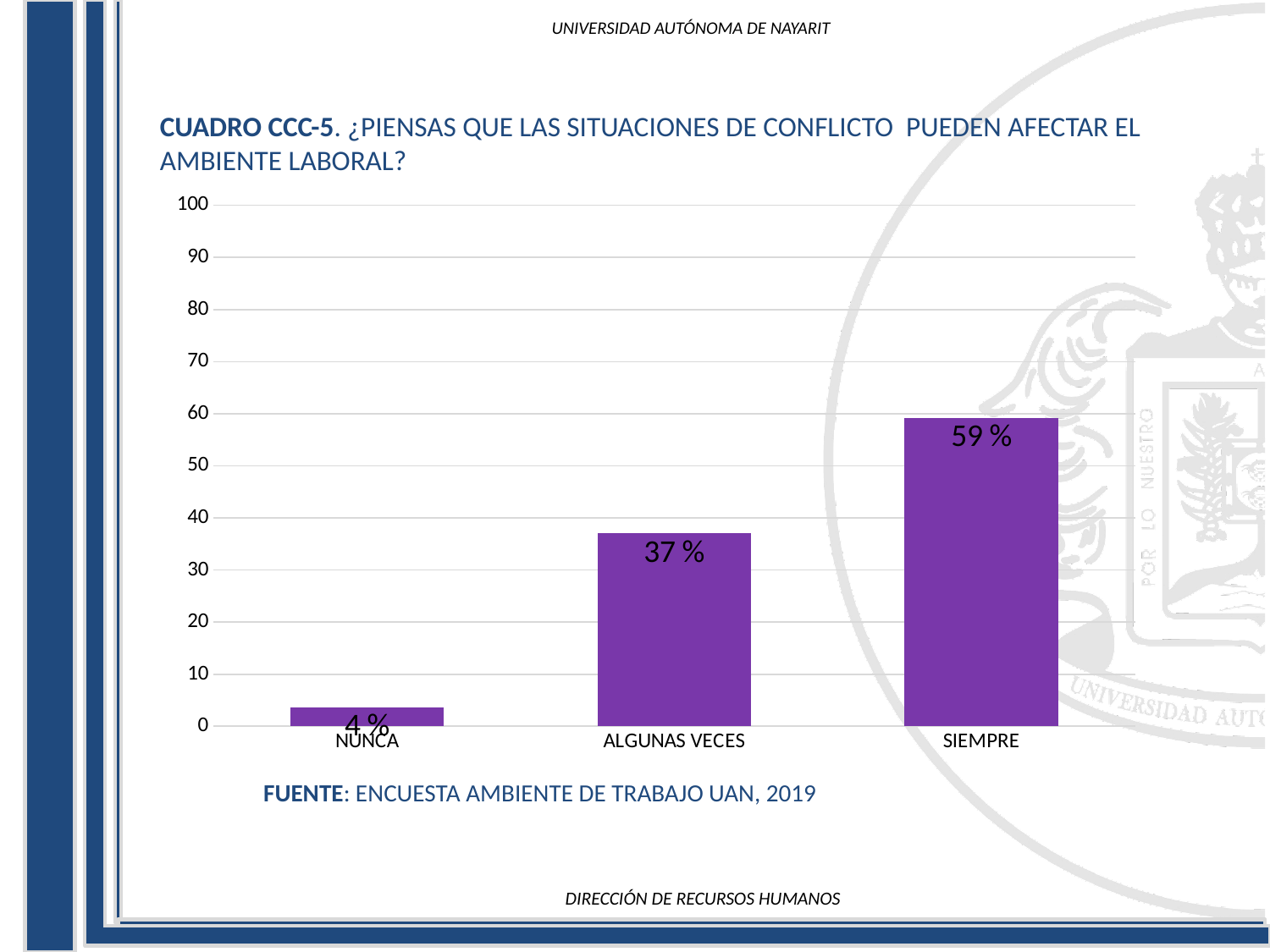
Do the values rise or fall from NUNCA to SIEMPRE along the x axis? rise What is the value for NUNCA? 4 % What is the value for SIEMPRE? 59 % What is the value for ALGUNAS VECES? 37 % What is the difference between the values for SIEMPRE and ALGUNAS VECES? 22 % Is the value for ALGUNAS VECES greater or less than 40? less What kind of chart is shown on the slide? bar chart Which is larger, the value for ALGUNAS VECES or the value for NUNCA? ALGUNAS VECES How many categories are shown on the x axis? 3 What source is cited below the chart? ENCUESTA AMBIENTE DE TRABAJO UAN, 2019 Which category has the lowest value? NUNCA Which category has the highest value? SIEMPRE